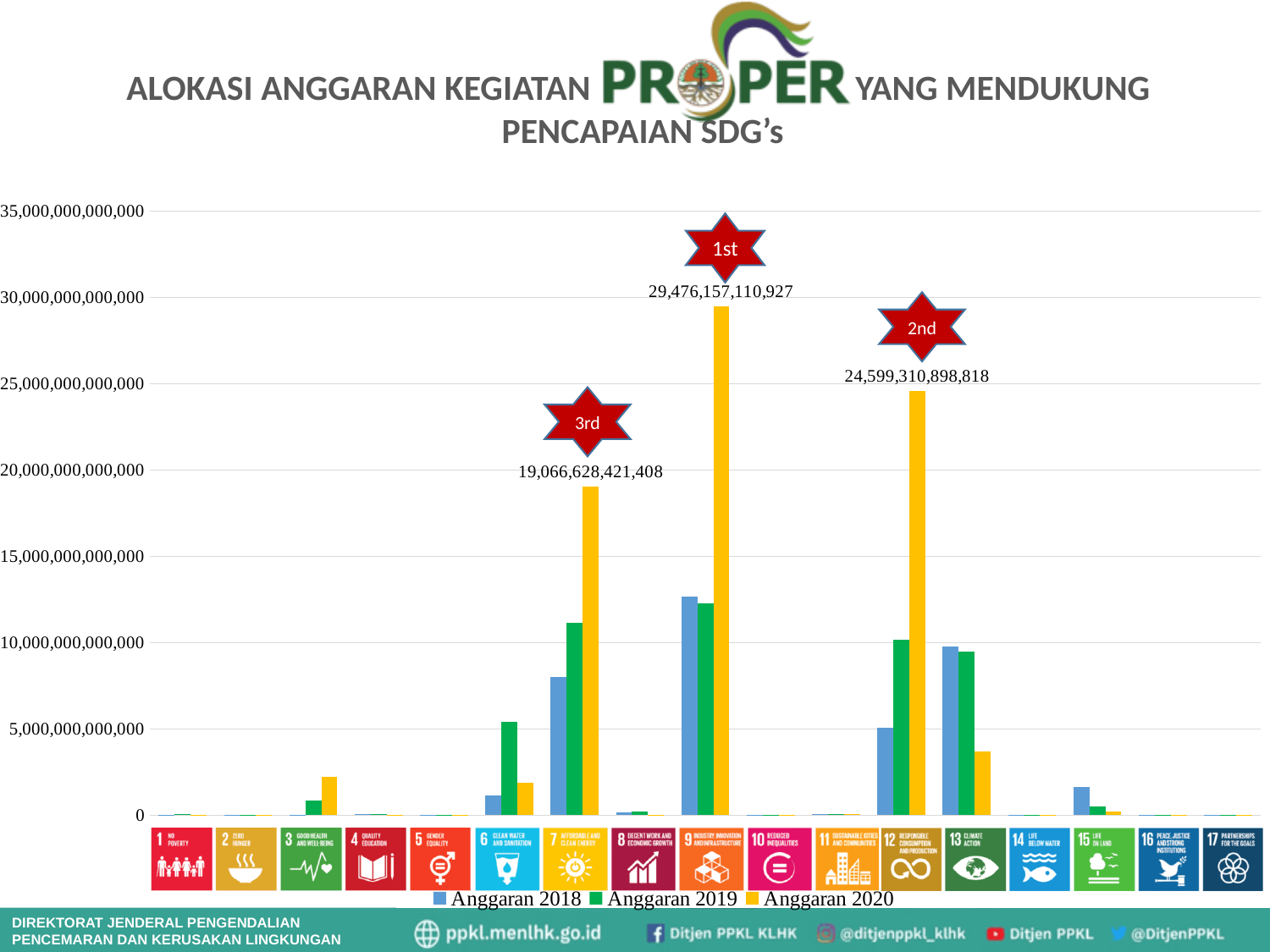
Is the Anggaran 2020 value for SDG 13 (Climate Action) greater or less than 5,000,000,000,000? less What is the value of the bar marked '1st' (Anggaran 2020 for SDG 9, Industry, Innovation and Infrastructure)? 29,476,157,110,927 Which SDG category has the highest Anggaran 2020 value? SDG 9 (Industry, Innovation and Infrastructure) What is the difference between the bar marked '1st' and the bar marked '2nd'? 4,876,846,212,109 What is the difference between the bar marked '2nd' and the bar marked '3rd'? 5,532,682,477,410 What are the three series listed in the legend? Anggaran 2018, Anggaran 2019, Anggaran 2020 How many series does the legend list? 3 What is the value of the bar marked '2nd' (Anggaran 2020 for SDG 12, Responsible Consumption and Production)? 24,599,310,898,818 What kind of chart is shown on the slide? Bar chart Is the Anggaran 2018 value for SDG 9 (Industry, Innovation and Infrastructure) greater or less than 10,000,000,000,000? greater For SDG 7 (Affordable and Clean Energy), which is larger: Anggaran 2018 or Anggaran 2019? Anggaran 2019 What is the value of the bar marked '3rd' (Anggaran 2020 for SDG 7, Affordable and Clean Energy)? 19,066,628,421,408